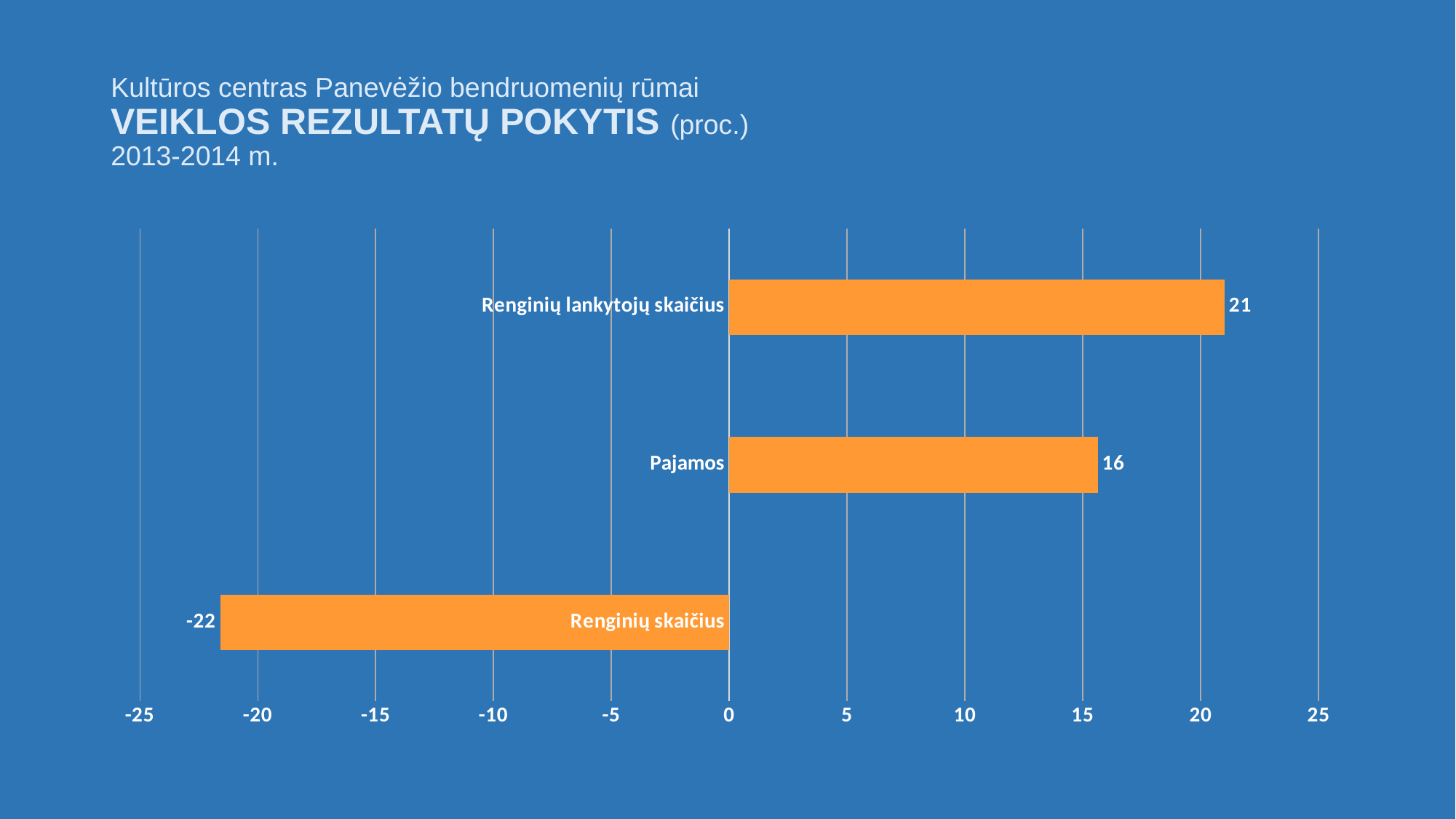
Which years does the chart title say the change covers? 2013-2014 m. What kind of chart is shown on the slide? bar chart How many categories are shown in the chart? 3 Which category has the highest value? Renginių lankytojų skaičius What is the difference between the values for Renginių lankytojų skaičius and Pajamos? 5 Is the value for Pajamos greater or less than 20? less What is the value for Pajamos? 16 Which category has the lowest value? Renginių skaičius Is the value for Renginių skaičius greater or less than -20? less What is the value for Renginių lankytojų skaičius? 21 Which is larger, the value for Pajamos or the value for Renginių lankytojų skaičius? Renginių lankytojų skaičius What is the value for Renginių skaičius? -22